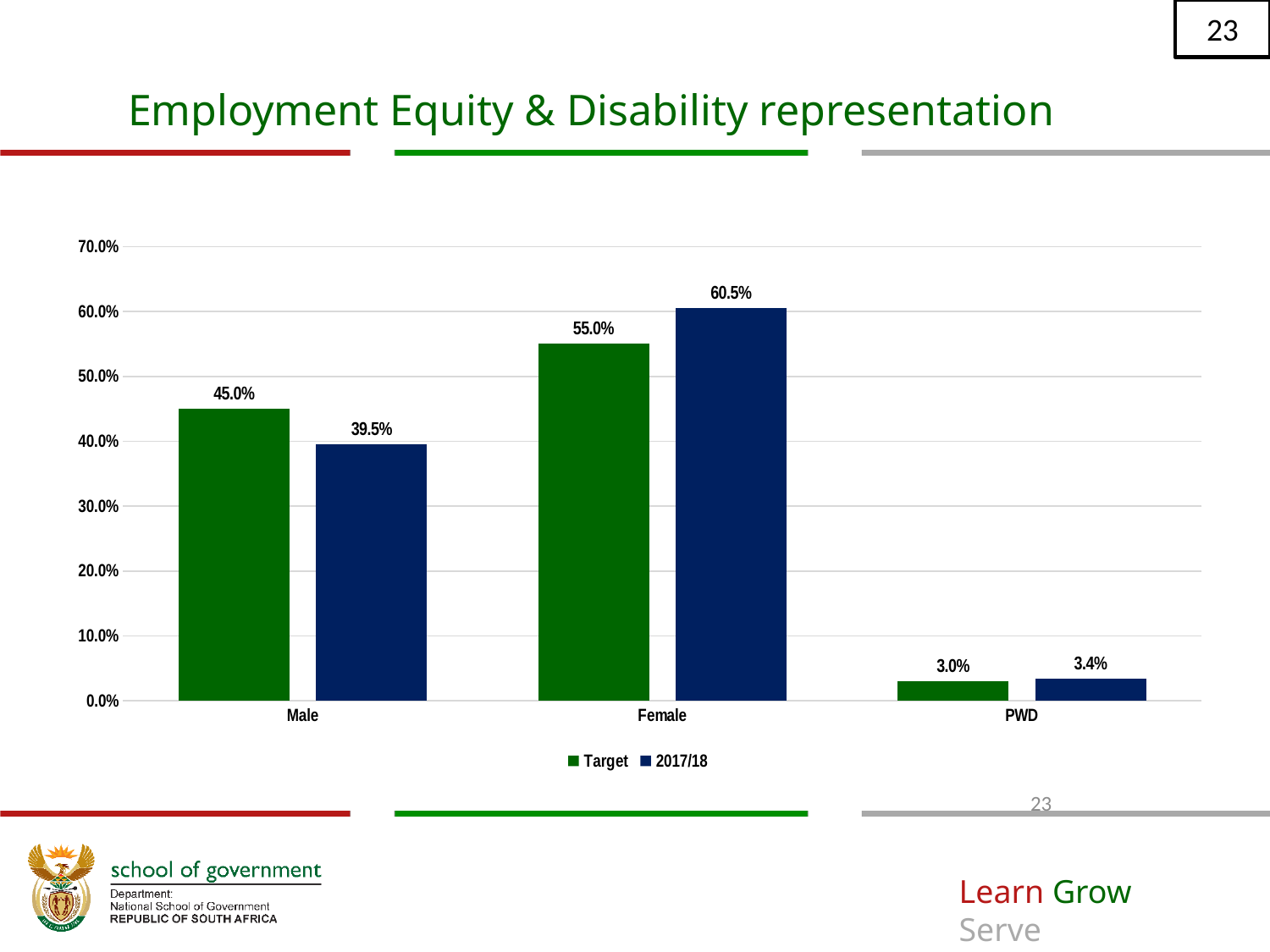
What is the Target value for Male? 45.0% What is the difference between the 2017/18 and Target values for Female? 5.5% How many categories are shown on the x axis? 3 Is the 2017/18 value for Male greater or less than 40.0%? less What is the 2017/18 value for Female? 60.5% Which category has the highest 2017/18 value? Female Which is larger for Male: the Target value or the 2017/18 value? Target What kind of chart is shown on the slide? bar chart How many series does the legend list? 2 Which category has the lowest Target value? PWD What is the difference between the Target and 2017/18 values for Male? 5.5% What is the 2017/18 value for PWD? 3.4%